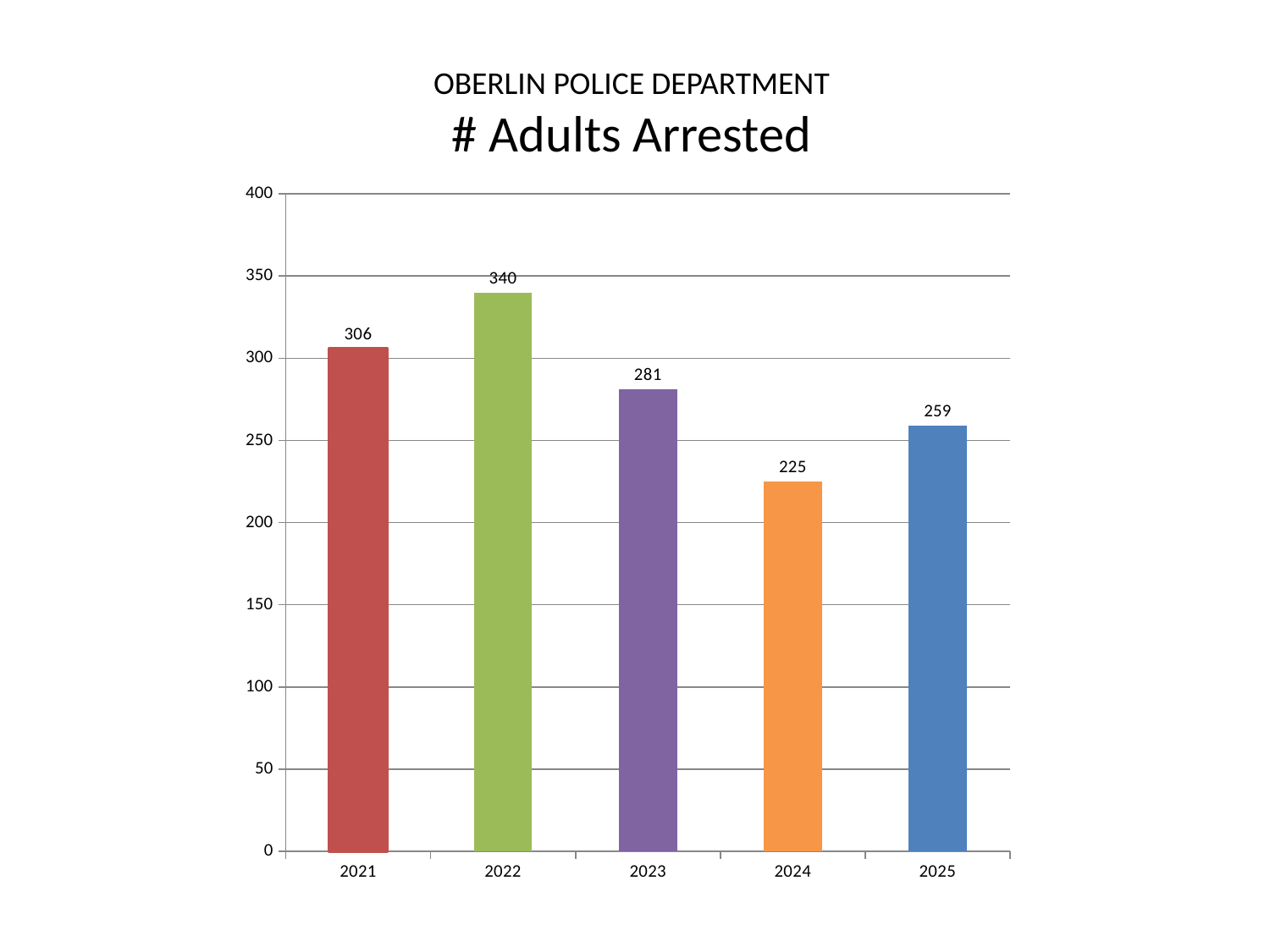
How many adults were arrested in 2022? 340 What is the value shown for 2025? 259 Which year has the lowest number of adults arrested? 2024 Is the value for 2023 greater or less than 300? less Which year has the highest number of adults arrested? 2022 What kind of chart is shown on the slide? bar chart What is the value shown for 2024? 225 What is the difference between the values for 2021 and 2023? 25 What is the title of the chart? # Adults Arrested What is the difference between the values for 2022 and 2024? 115 Which is larger, the value for 2021 or the value for 2025? 2021 How many years are shown on the x axis? 5